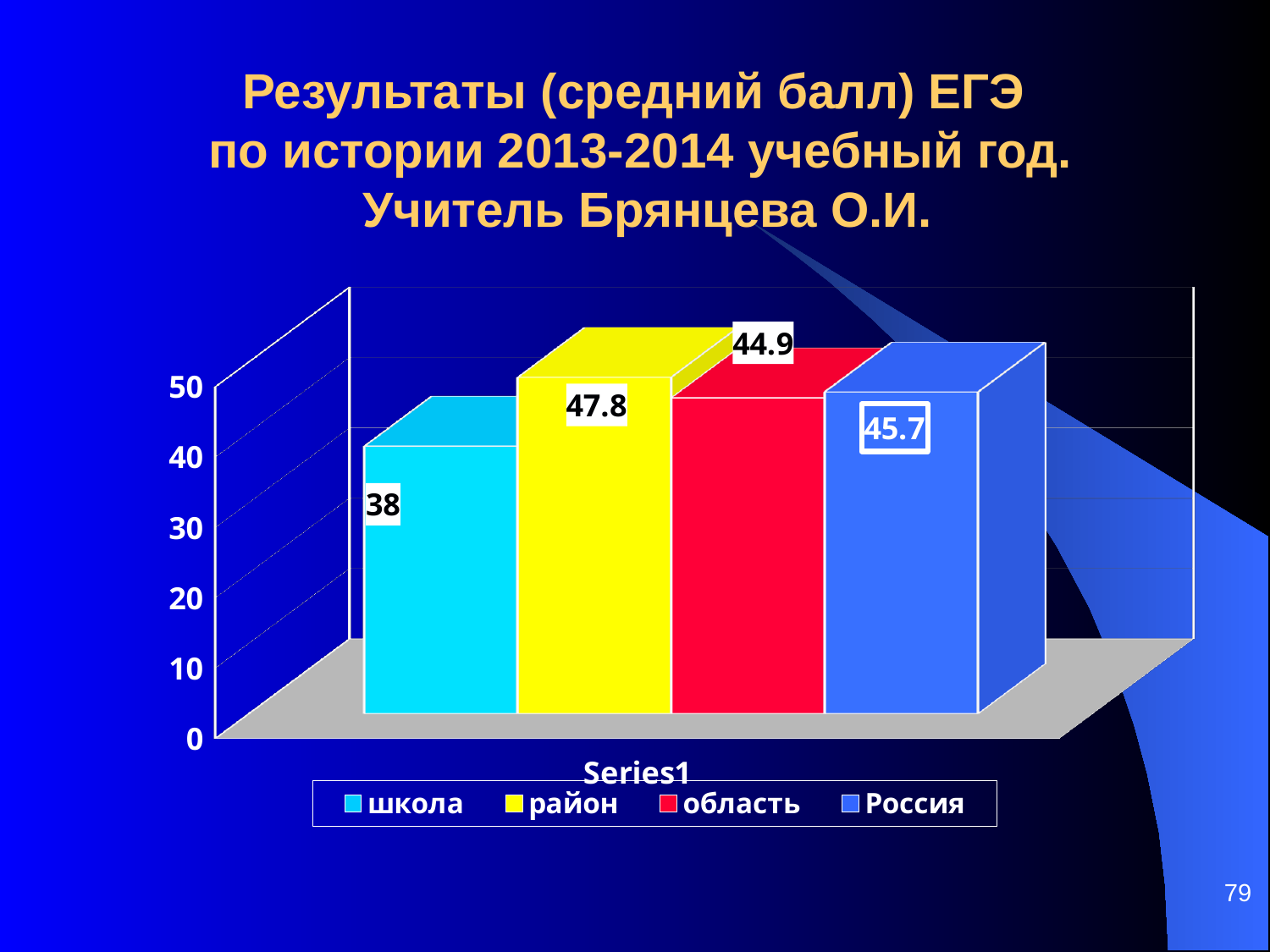
What is the difference between the values for Россия and область? 0.8 Is the value for школа greater or less than 40? less Which is larger, the value for область or the value for Россия? Россия How many bars are plotted in the chart? 4 What is the value shown for школа? 38 What is the value shown for Россия? 45.7 What kind of chart is shown on the slide? bar chart What is the difference between the values for район and школа? 9.8 Which category has the highest value? район Which category has the lowest value? школа What is the value shown for район? 47.8 What is the value shown for область? 44.9